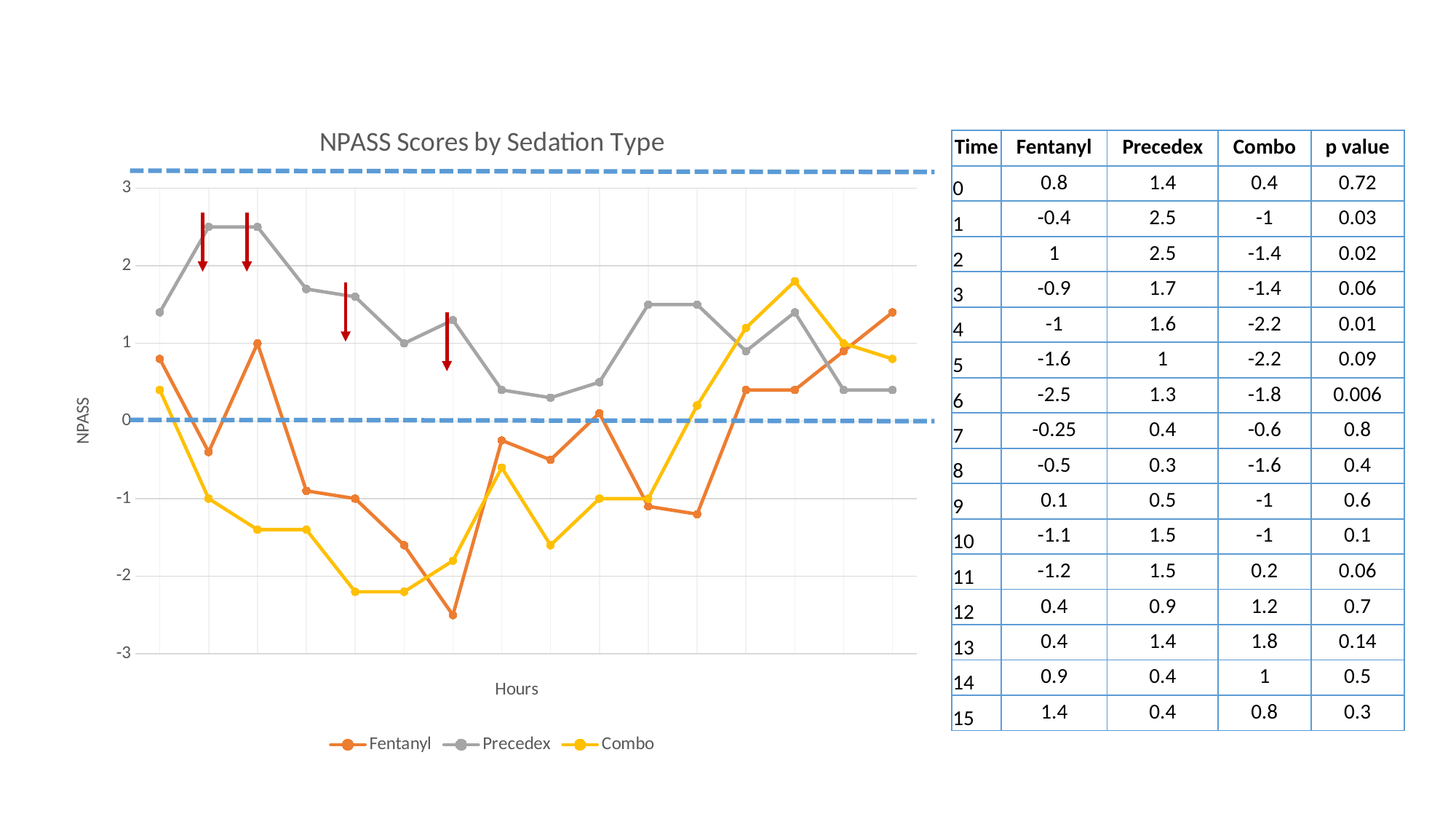
What is the Fentanyl NPASS score at time 6? -2.5 What is the title of the chart? NPASS Scores by Sedation Type How many series does the chart legend list? 3 Does the Combo series rise or fall from time 11 to time 13? rise At time 13, which is larger: the Combo score or the Precedex score? Combo Which sedation type has the highest NPASS score at time 2? Precedex What kind of chart is shown on the slide? line chart Is the Precedex value at time 1 greater or less than 2? greater What is the lowest NPASS score reached by the Combo series? -2.2 What is the difference between the Precedex and Combo NPASS scores at time 4? 3.8 What is the Precedex NPASS score at time 1? 2.5 How many time points are plotted for each series in the NPASS Scores by Sedation Type chart? 16